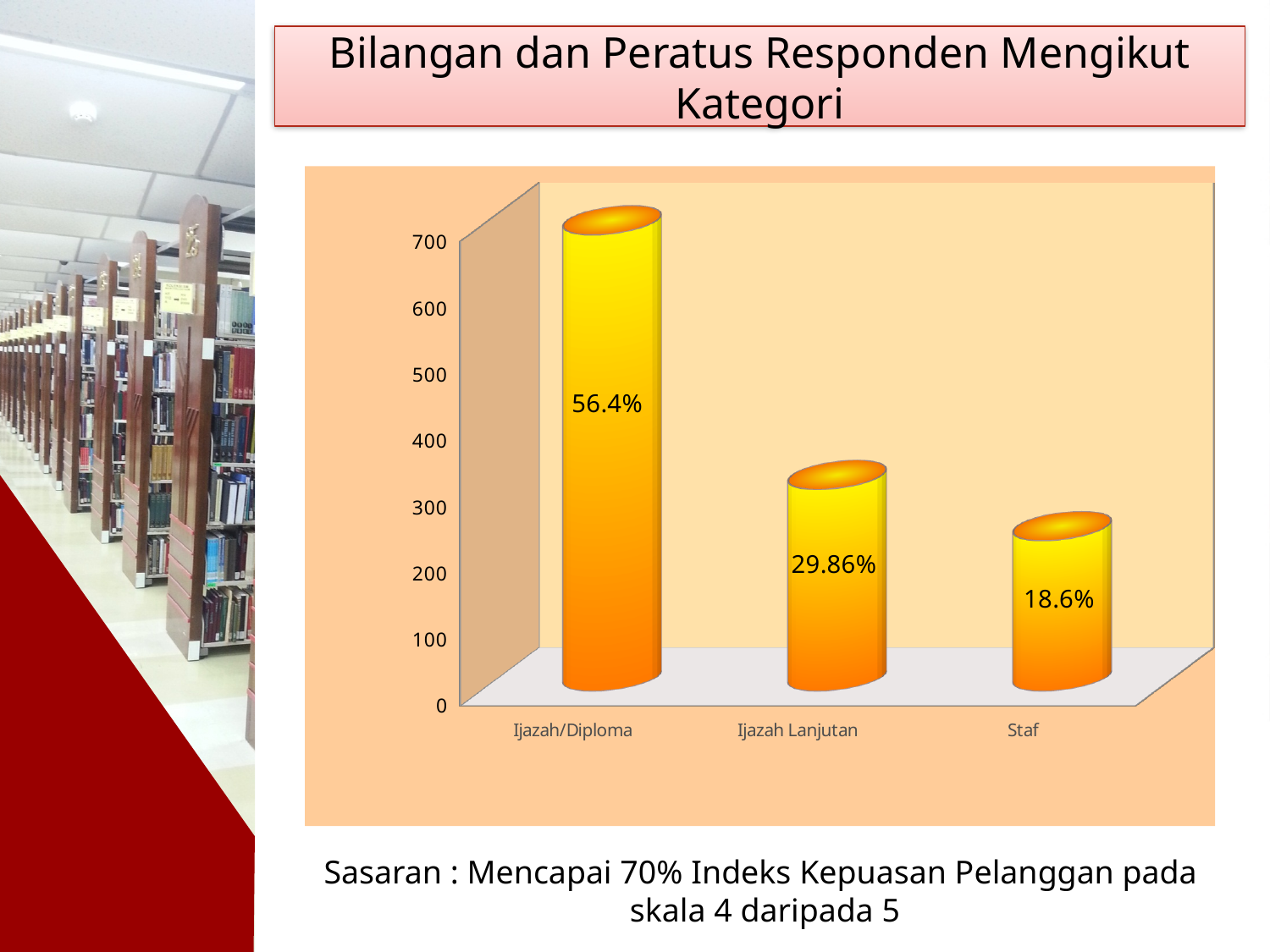
What percentage is labelled on the bar for Ijazah Lanjutan? 29.86% Do the bar values rise or fall from left to right along the x axis? fall What percentage is labelled on the bar for Staf? 18.6% Which category has the highest bar? Ijazah/Diploma Which is larger, the bar for Ijazah Lanjutan or the bar for Staf? Ijazah Lanjutan How many categories are shown on the x axis of the chart? 3 Is the value for Ijazah/Diploma greater or less than 500? greater Which category has the lowest bar? Staf What kind of chart is shown on the slide? bar chart What is the difference between the percentage labels for Ijazah/Diploma and Ijazah Lanjutan? 26.54% What is the title of the chart on the slide? Bilangan dan Peratus Responden Mengikut Kategori What percentage is labelled on the bar for Ijazah/Diploma? 56.4%